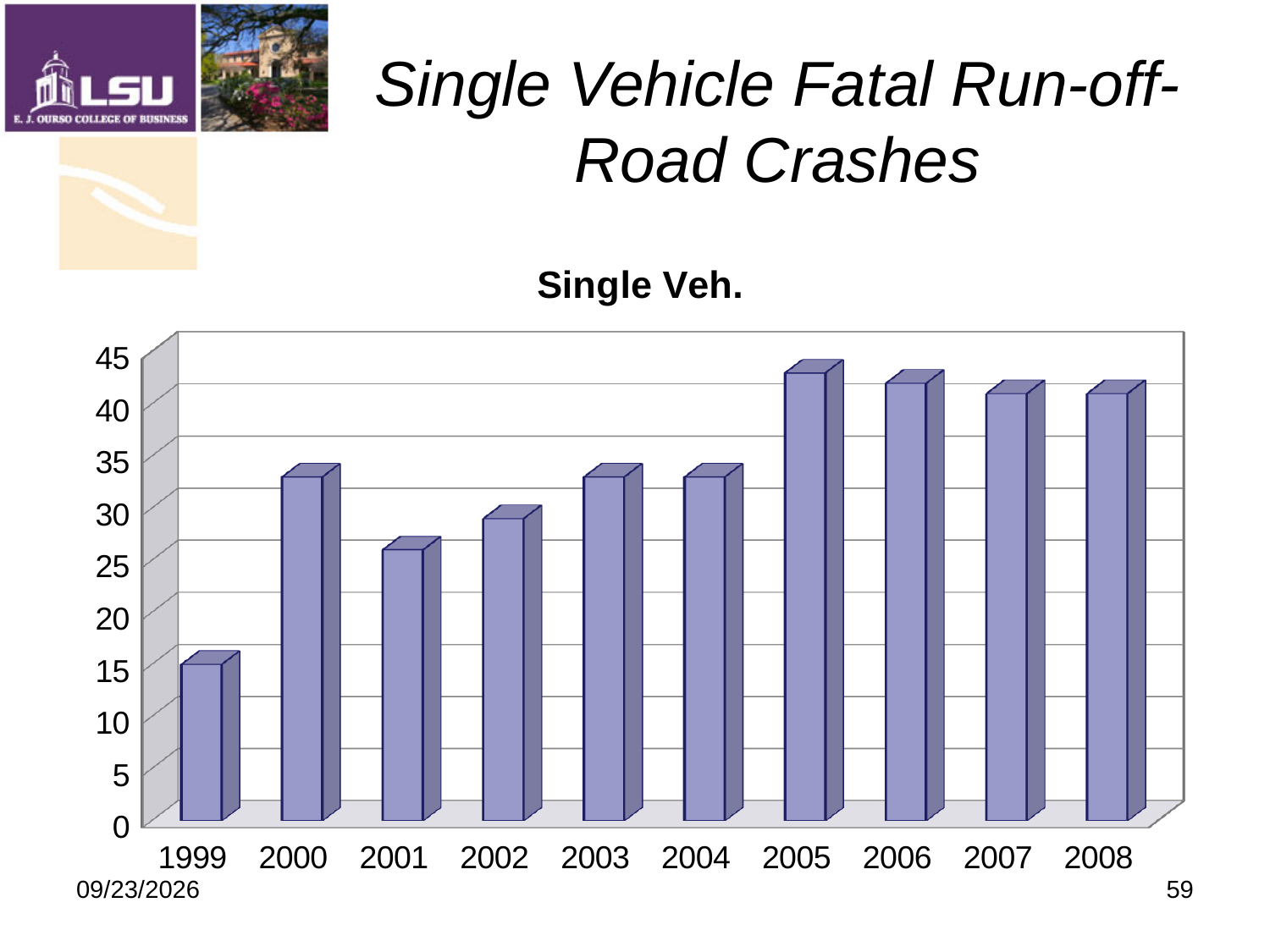
Is the value for 2005 greater or less than 40? greater Is the value for 2001 greater or less than 30? less Is the value for 2000 greater or less than 30? greater Which year has the larger value, 2001 or 2002? 2002 What kind of chart is shown on the slide? bar chart Which year has the larger value, 1999 or 2000? 2000 Which year has the highest number of single vehicle fatal run-off-road crashes? 2005 Which year has the lowest number of single vehicle fatal run-off-road crashes? 1999 What is the title printed above the chart? Single Veh. How many years are shown on the x axis of the chart? 10